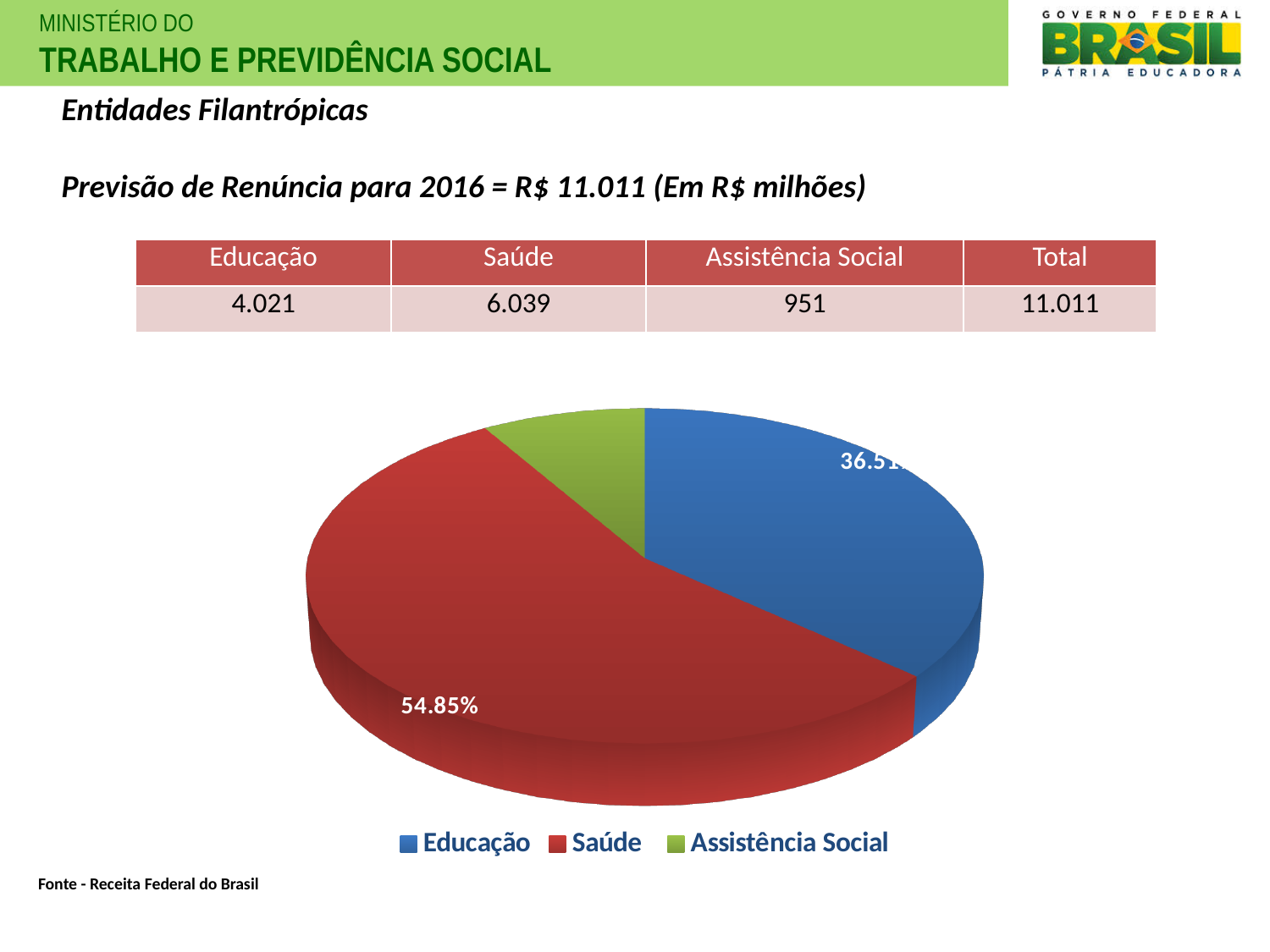
Which category is shown in green in the pie chart? Assistência Social Which slice is larger in the pie chart, Educação or Assistência Social? Educação What share of the pie is labelled for Saúde? 54.85% Is the share for Assistência Social greater or less than 10%? less How many entries does the pie chart's legend list? 3 Which category has the largest slice of the pie chart? Saúde What colour is the Saúde slice in the pie chart? red Which category has the smallest slice of the pie chart? Assistência Social Is the share for Saúde greater or less than 50%? greater Which slice is larger in the pie chart, Saúde or Educação? Saúde How many slices does the pie chart have? 3 What kind of chart is shown on the slide? pie chart